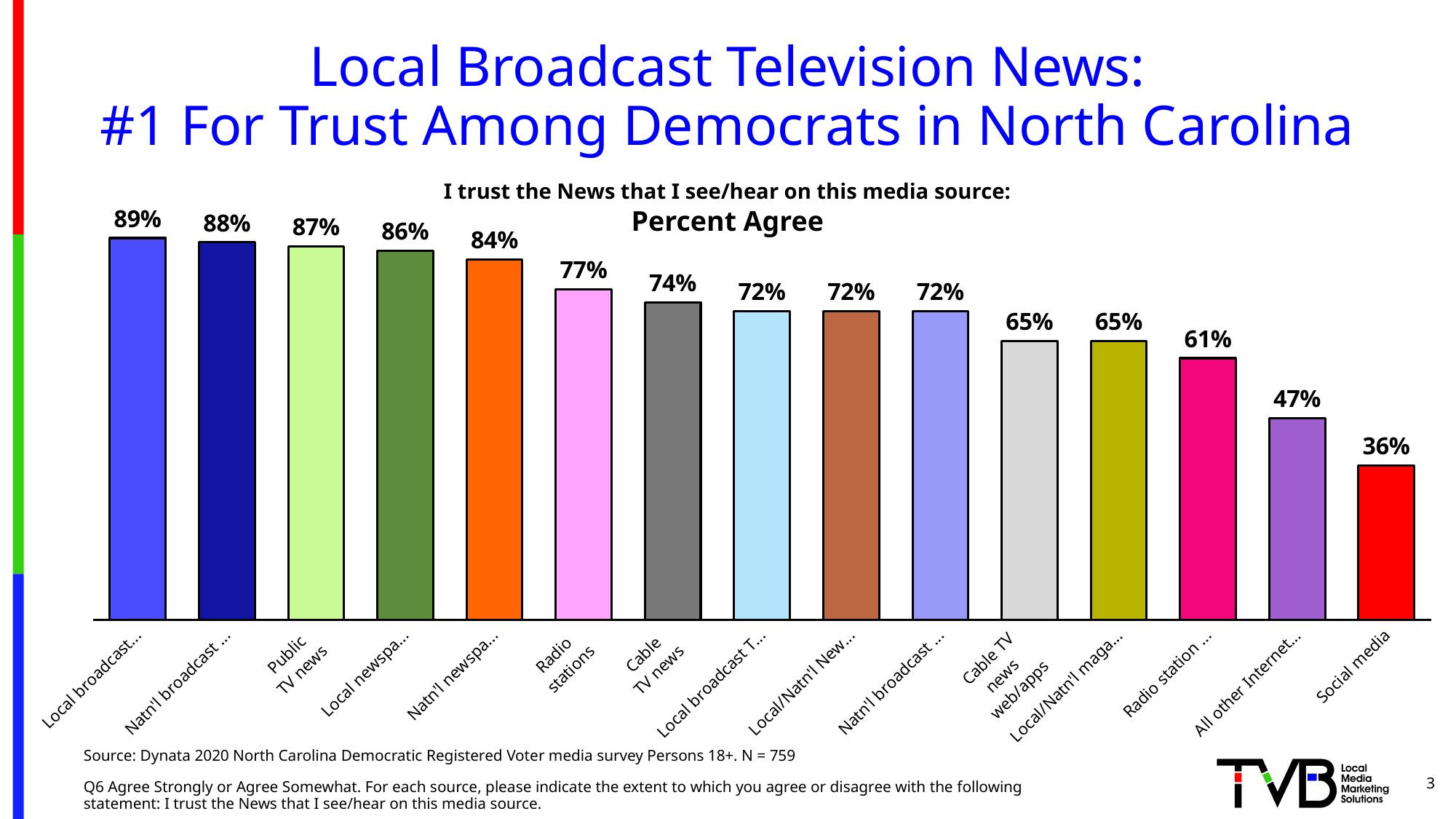
What is the percent agree value for Social media? 36% Which has a higher percent agree value, Radio stations or Cable TV news? Radio stations What kind of chart is shown on the slide? bar chart How many media sources (bars) are shown in the chart? 15 What is the percent agree value for Cable TV news web/apps? 65% What is the percent agree value for Radio stations? 77% Do the bar values rise or fall from left to right across the chart? fall What is the highest percent agree value shown in the chart? 89% What is the percent agree value for Public TV news? 87% What is the difference in percent agree between Public TV news and Social media? 51 percentage points What is the percent agree value for Cable TV news? 74% Which media source has the lowest percent agree value? Social media